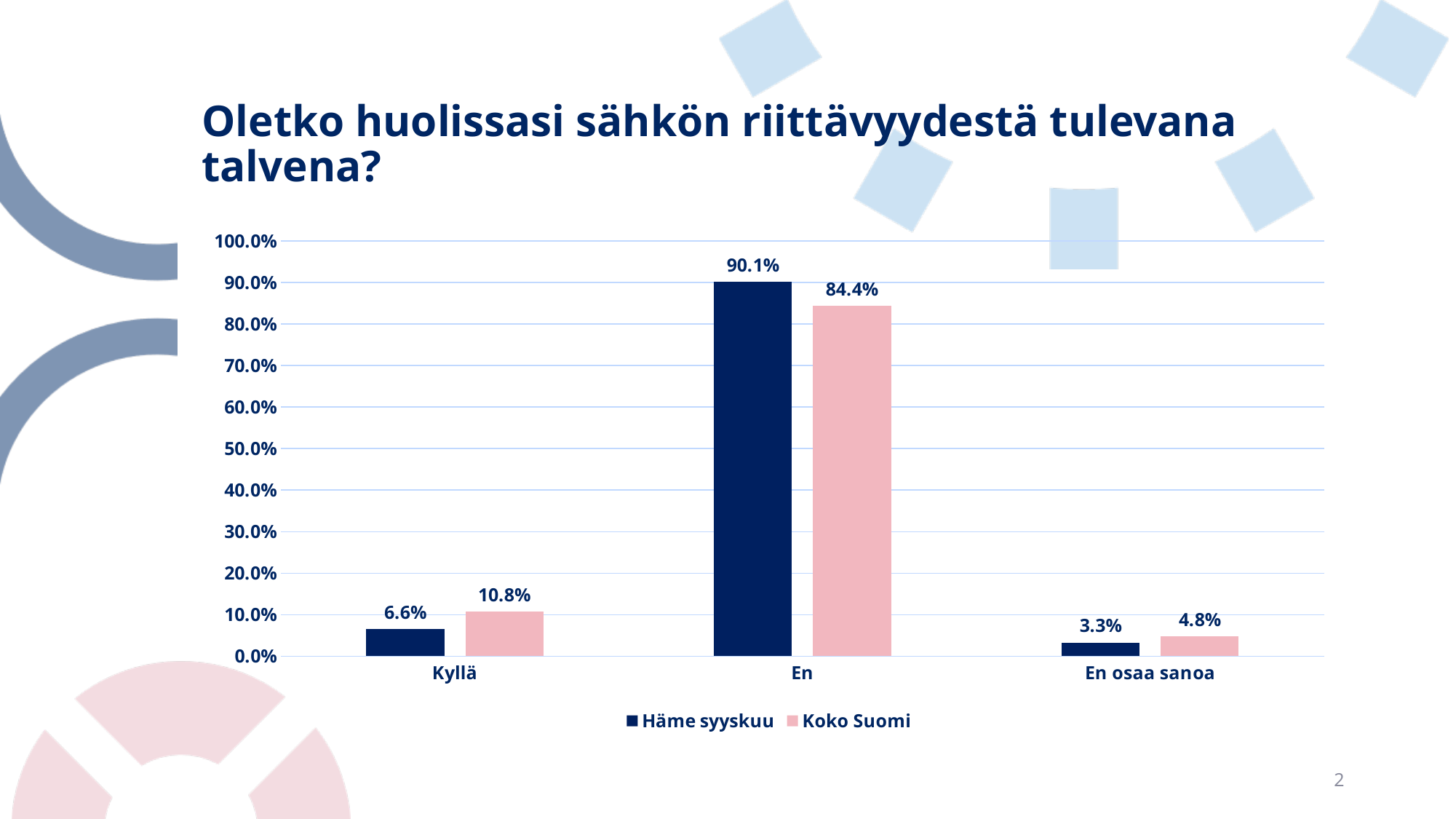
What kind of chart is shown on the slide? Bar chart How many series does the legend list? 2 What is the value for Koko Suomi in the En category? 84.4% What is the difference between Häme syyskuu and Koko Suomi in the En category? 5.7% What is the value for Häme syyskuu in the Kyllä category? 6.6% Which category has the highest value for Häme syyskuu? En What is the value for Häme syyskuu in the En osaa sanoa category? 3.3% What is the value for Koko Suomi in the Kyllä category? 10.8% What colour are the Koko Suomi bars? Pink How many categories are shown on the x axis? 3 In the Kyllä category, which series has the larger value, Häme syyskuu or Koko Suomi? Koko Suomi Which category has the lowest value for Koko Suomi? En osaa sanoa